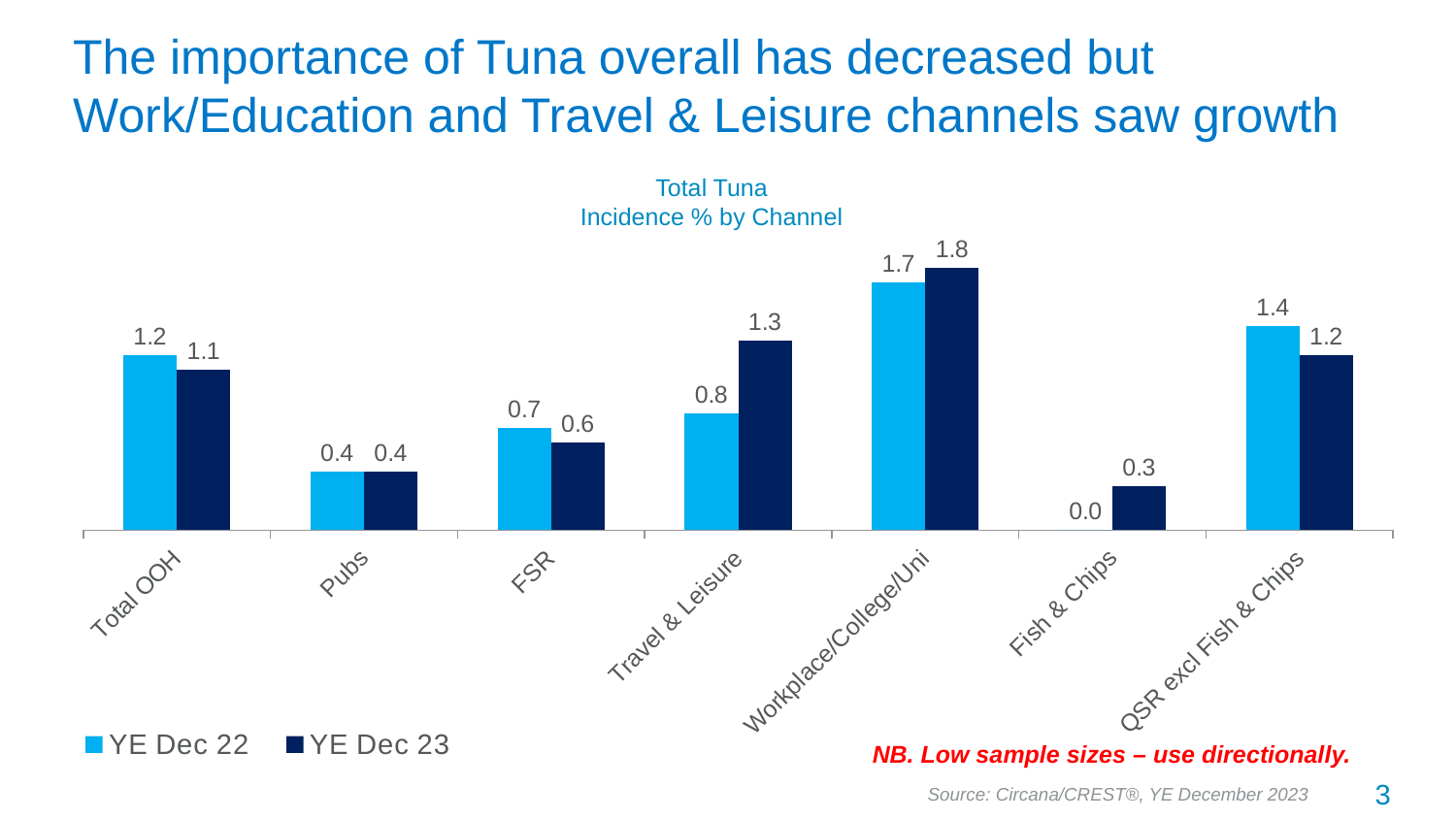
What is the YE Dec 22 value for Travel & Leisure? 0.8 Which series is shown in dark navy? YE Dec 23 What is the YE Dec 22 value for Fish & Chips? 0.0 Which is larger for QSR excl Fish & Chips: the YE Dec 22 value or the YE Dec 23 value? YE Dec 22 What is the title of the chart? Total Tuna Incidence % by Channel Which channel has the highest YE Dec 23 value? Workplace/College/Uni Which channel has the lowest YE Dec 22 value? Fish & Chips What kind of chart is shown? Bar chart How many series does the legend list? 2 What is the difference between the YE Dec 22 and YE Dec 23 values for Travel & Leisure? 0.5 What is the YE Dec 23 value for Workplace/College/Uni? 1.8 How many channels are shown on the x axis? 7